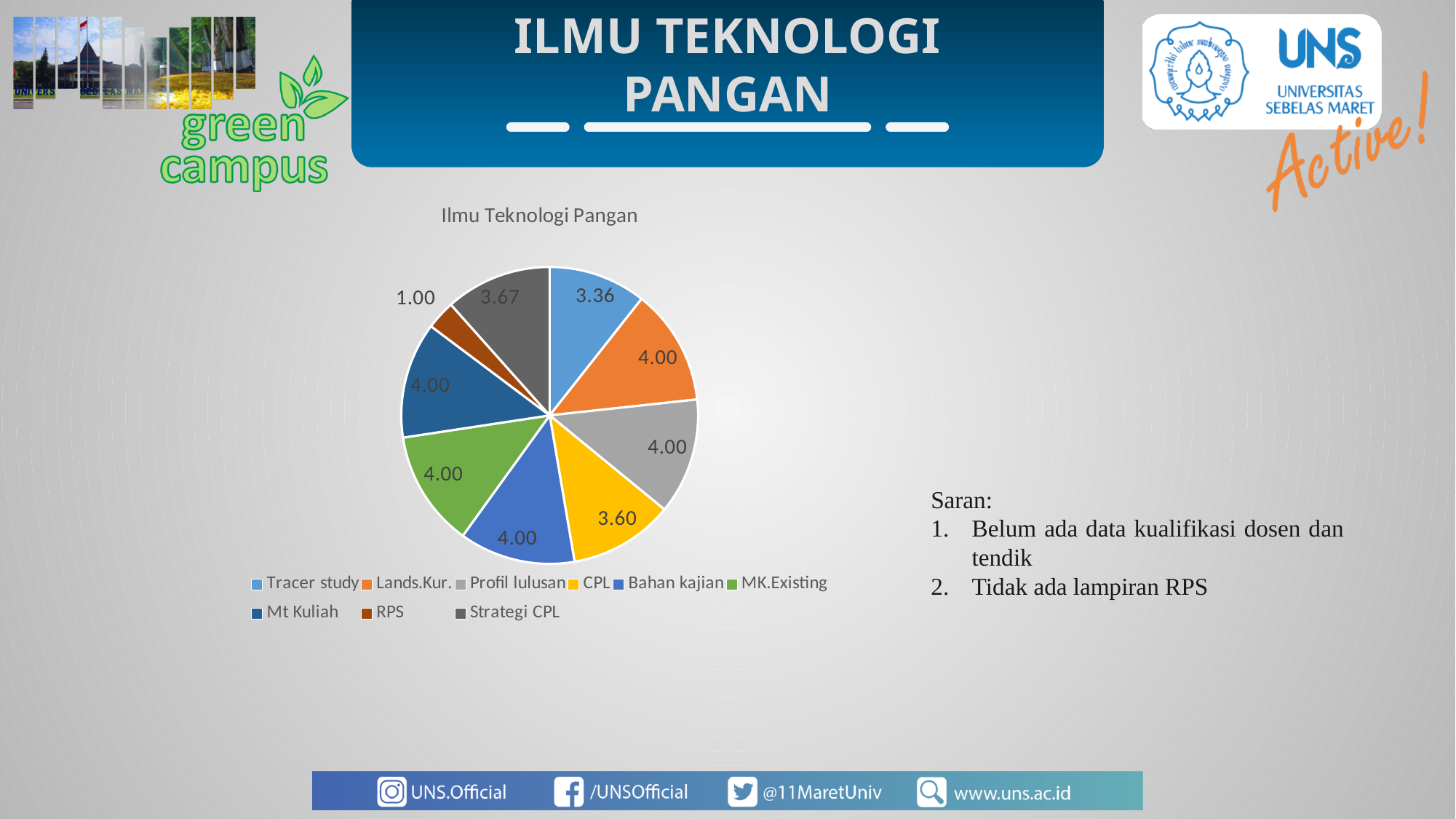
What is the value of the Lands.Kur. slice? 4.00 What is the value of the Tracer study slice? 3.36 What is the title of the pie chart? Ilmu Teknologi Pangan What is the value of the RPS slice? 1.00 What is the difference between the Strategi CPL value and the Tracer study value? 0.31 Which category has the smallest slice in the pie chart? RPS What is the difference between the Strategi CPL value and the RPS value? 2.67 What is the value of the CPL slice? 3.60 What is the value of the Strategi CPL slice? 3.67 Which is larger, the value for Tracer study or the value for CPL? CPL What type of chart is shown on the slide? Pie chart How many categories are shown in the pie chart? 9